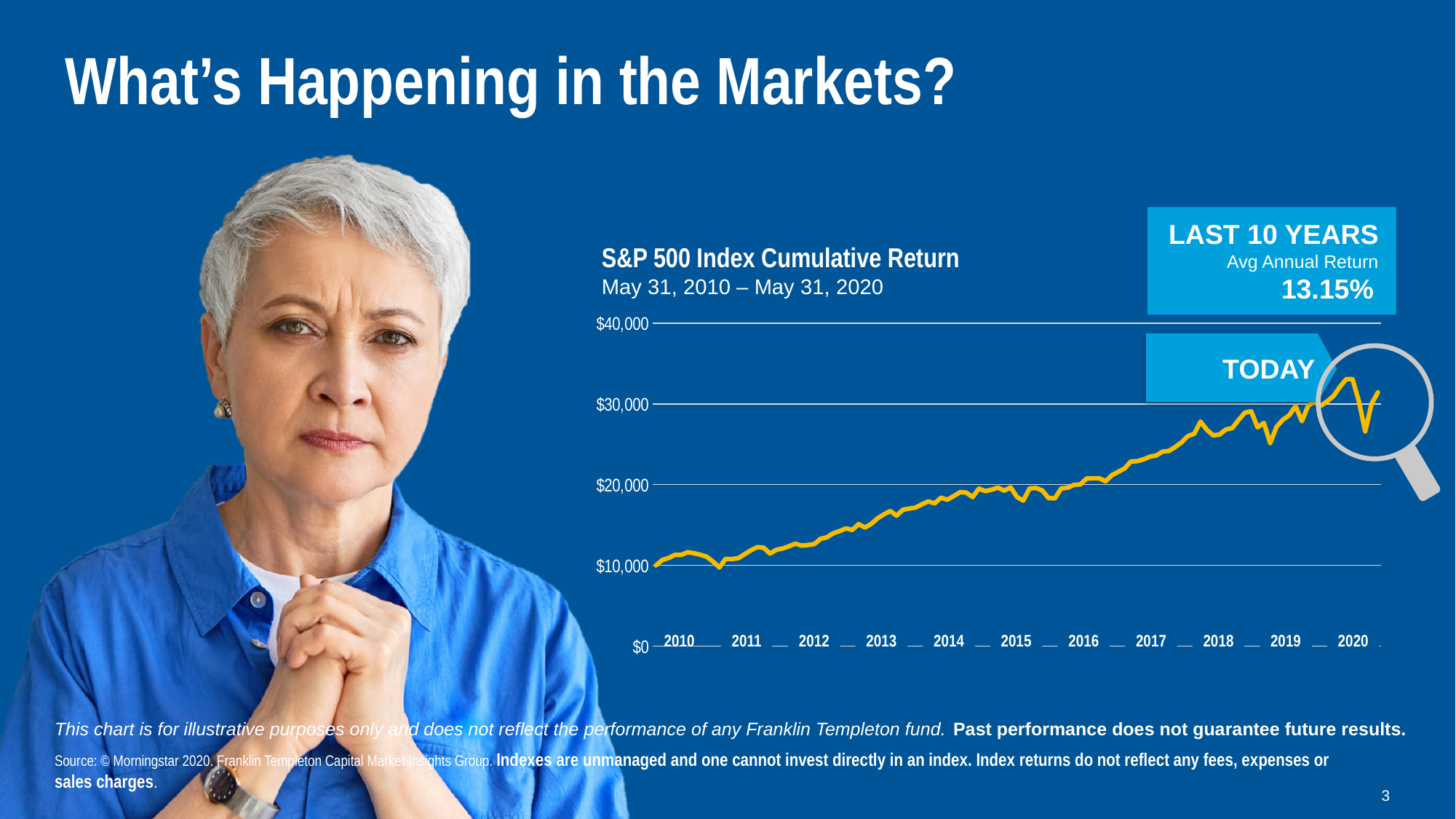
How many year labels are shown along the x axis? 11 Is the value at the end of the line in 2020 greater or less than $20,000? greater Overall, does the S&P 500 cumulative return line rise or fall from 2010 to 2020? Rise What kind of chart is shown on the slide? Line chart What is the title of the chart? S&P 500 Index Cumulative Return Is the value for 2012 greater or less than $20,000? less What average annual return over the last 10 years is shown in the callout box? 13.15% What date range does the chart cover, according to its subtitle? May 31, 2010 – May 31, 2020 Is the value for 2016 greater or less than $30,000? less Which year shows a higher cumulative return value, 2011 or 2019? 2019 What is the highest value labelled on the y axis? $40,000